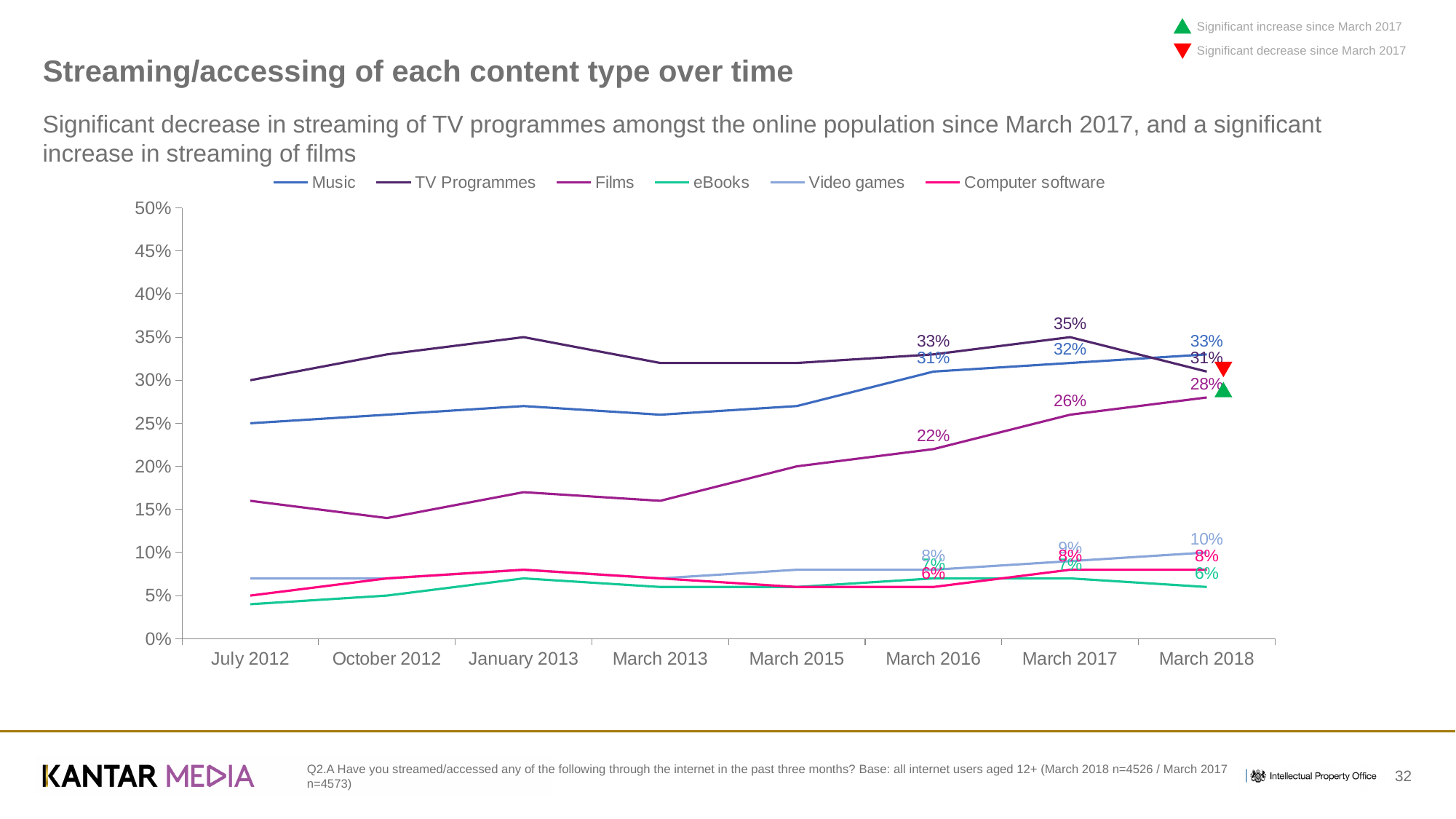
Which is larger in March 2018, Music or TV Programmes? Music How many time points are shown on the x axis? 8 By how many percentage points did TV Programmes fall from March 2017 to March 2018? 4 percentage points Which content type has the lowest value in March 2018? eBooks What is the value for Films in March 2016? 22% What is the value for Music in March 2018? 33% What kind of chart is shown on the slide? line chart What is the value for TV Programmes in March 2017? 35% How many series does the legend list? 6 What is the value for Video games in March 2018? 10% Is the value for TV Programmes in July 2012 greater or less than 25%? greater Which content type has the highest value in March 2017? TV Programmes